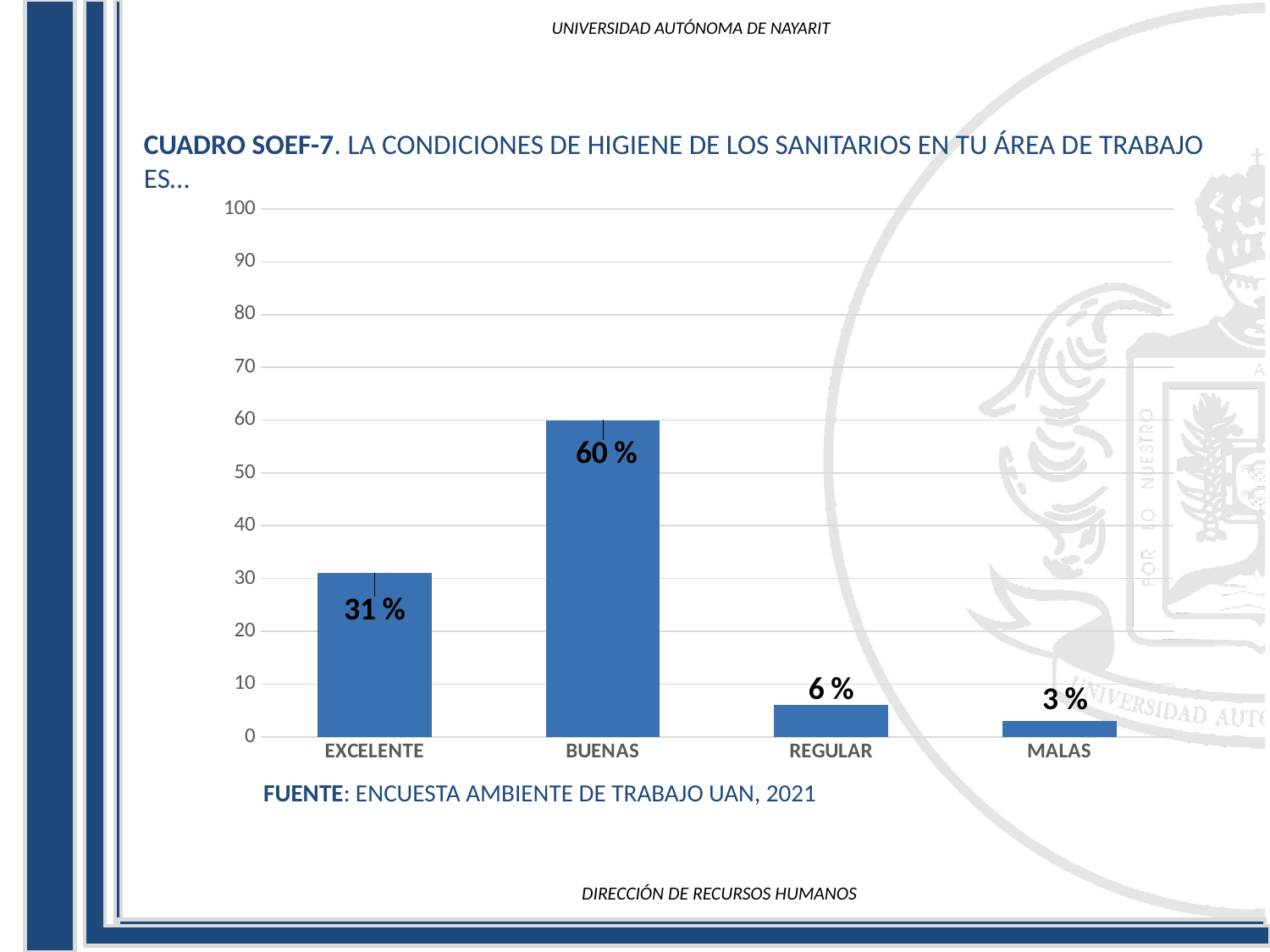
What is the value for MALAS? 3 % How many categories are shown on the x axis? 4 Is the value for EXCELENTE greater or less than 40? less Which is larger, the value for REGULAR or the value for MALAS? REGULAR What kind of chart is shown on the slide? bar chart What is the value for REGULAR? 6 % What source is cited below the chart? ENCUESTA AMBIENTE DE TRABAJO UAN, 2021 What is the value for EXCELENTE? 31 % What is the difference between the values for BUENAS and EXCELENTE? 29 % What is the value for BUENAS? 60 % Which category has the lowest value? MALAS Which category has the highest value? BUENAS